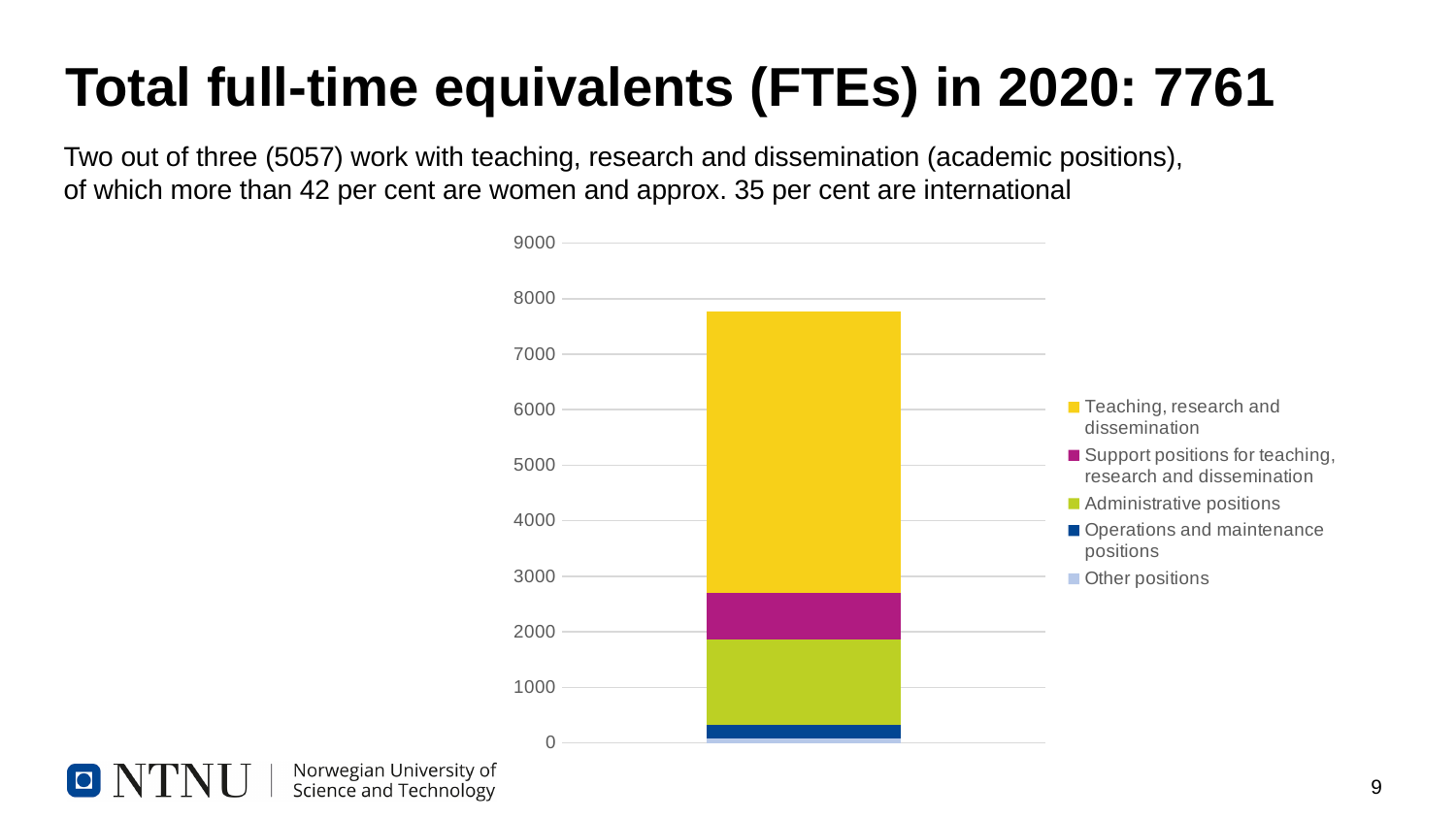
How many bars are plotted in the chart? 1 How many series does the legend list? 5 Is the Operations and maintenance positions segment greater or less than 1000? less Which segment is larger: Administrative positions or Support positions for teaching, research and dissemination? Administrative positions According to the slide, what is the total of the stacked bar (total FTEs in 2020)? 7761 Is the total height of the stacked bar greater or less than 7000? greater Is the Administrative positions segment greater or less than 1000? greater Which series is listed last in the legend? Other positions What kind of chart is shown on the slide? Stacked bar chart Which series makes up the largest segment of the stacked bar? Teaching, research and dissemination What colour represents Teaching, research and dissemination in the chart? Yellow